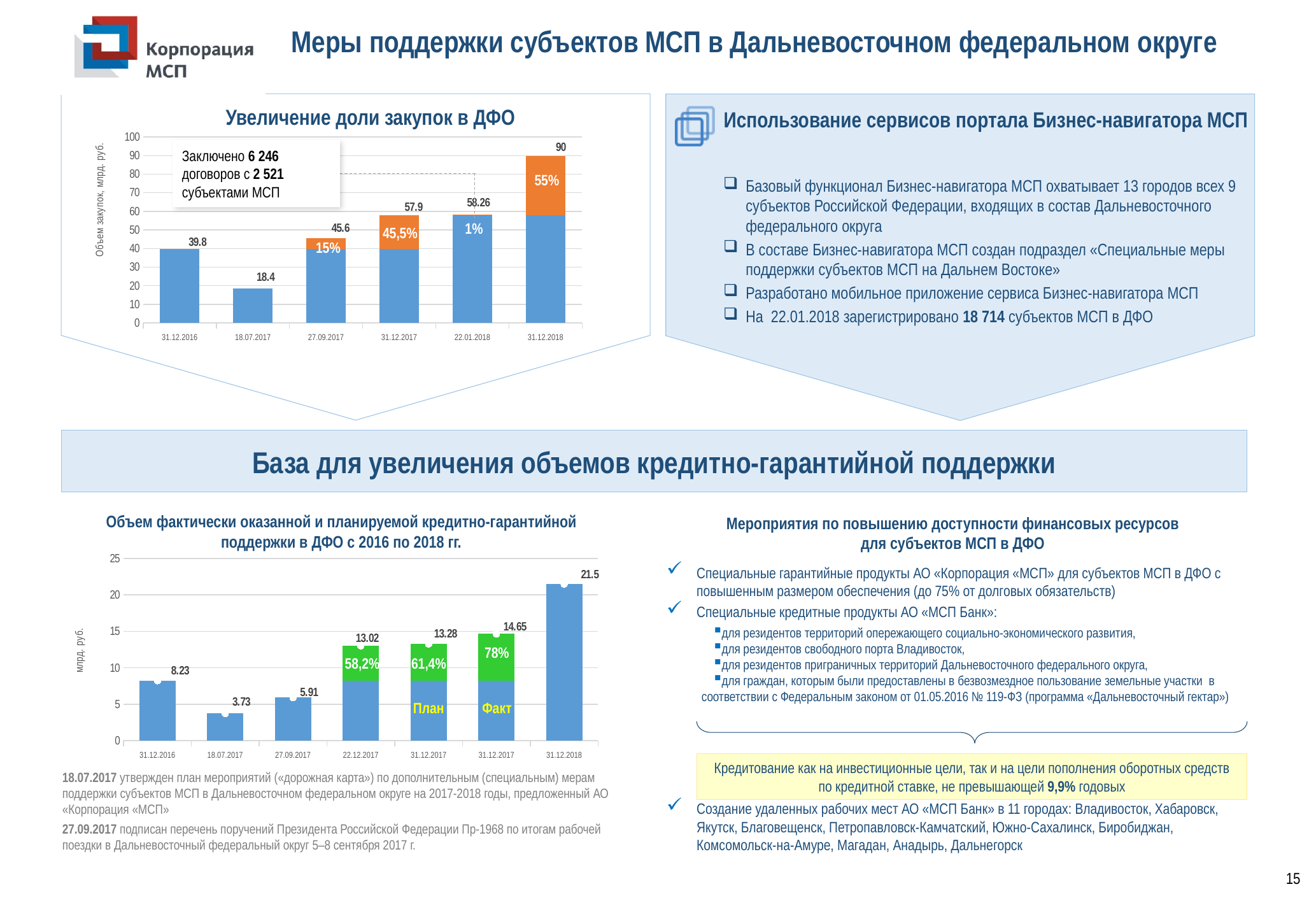
In the chart 'Увеличение доли закупок в ДФО', which date has the highest value? 31.12.2018 In the chart 'Увеличение доли закупок в ДФО', what is the value labelled for 31.12.2016? 39.8 In the chart 'Объем фактически оказанной и планируемой кредитно-гарантийной поддержки в ДФО с 2016 по 2018 гг.', which is larger: the value for 27.09.2017 or the value for 18.07.2017? 27.09.2017 In the chart 'Увеличение доли закупок в ДФО', what is the value labelled for 31.12.2018? 90 In the chart 'Увеличение доли закупок в ДФО', what percentage is printed on the orange segment of the 31.12.2018 bar? 55% What kind of chart is 'Объем фактически оказанной и планируемой кредитно-гарантийной поддержки в ДФО с 2016 по 2018 гг.'? Bar chart In the chart 'Увеличение доли закупок в ДФО', which date has the lowest value? 18.07.2017 In the chart 'Объем фактически оказанной и планируемой кредитно-гарантийной поддержки в ДФО с 2016 по 2018 гг.', what is the value labelled for 31.12.2018? 21.5 In the chart 'Увеличение доли закупок в ДФО', how many dates are shown on the x axis? 6 In the chart 'Объем фактически оказанной и планируемой кредитно-гарантийной поддержки в ДФО с 2016 по 2018 гг.', which date has the lowest value? 18.07.2017 In the chart 'Увеличение доли закупок в ДФО', what is the difference between the values for 31.12.2018 and 31.12.2016? 50.2 In the chart 'Объем фактически оказанной и планируемой кредитно-гарантийной поддержки в ДФО с 2016 по 2018 гг.', what is the value labelled for 31.12.2016? 8.23